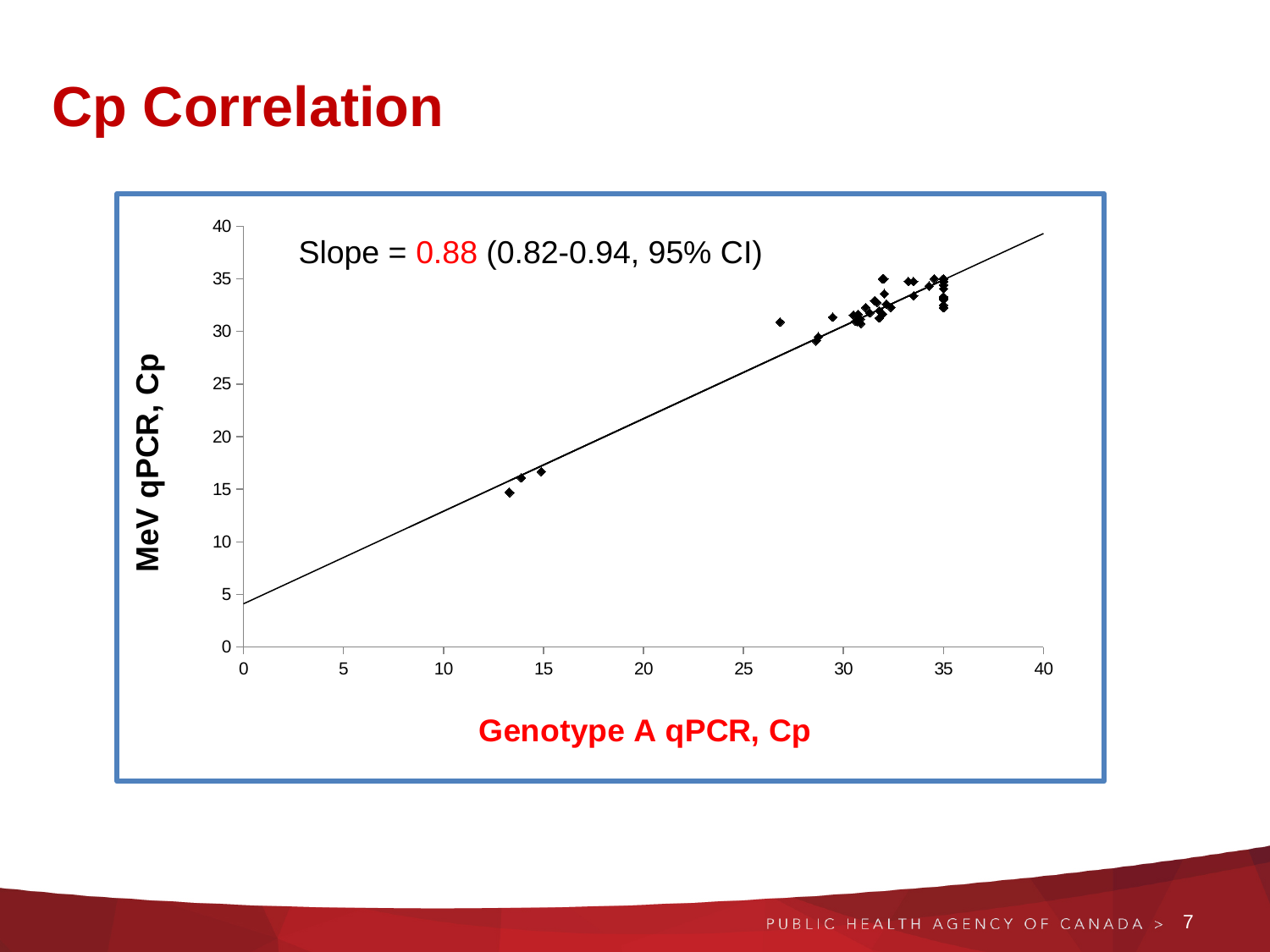
Which group of points has higher MeV qPCR Cp values: those with Genotype A qPCR Cp near 14 or those near 32? Those near 32 What slope is reported for the fitted line on the chart? 0.88 Is the MeV qPCR Cp value for the point with Genotype A qPCR Cp near 27 greater or less than 25? greater What kind of chart is shown on the slide? Scatter chart Are the MeV qPCR Cp values for the points with Genotype A qPCR Cp near 14 greater or less than 10? greater What is the maximum value shown on the y axis of the chart? 40 Are the MeV qPCR Cp values for the points with Genotype A qPCR Cp near 35 greater or less than 30? greater Do the plotted points rise or fall as the Genotype A qPCR Cp value increases along the x axis? Rise What is the title of the x axis of the chart? Genotype A qPCR, Cp